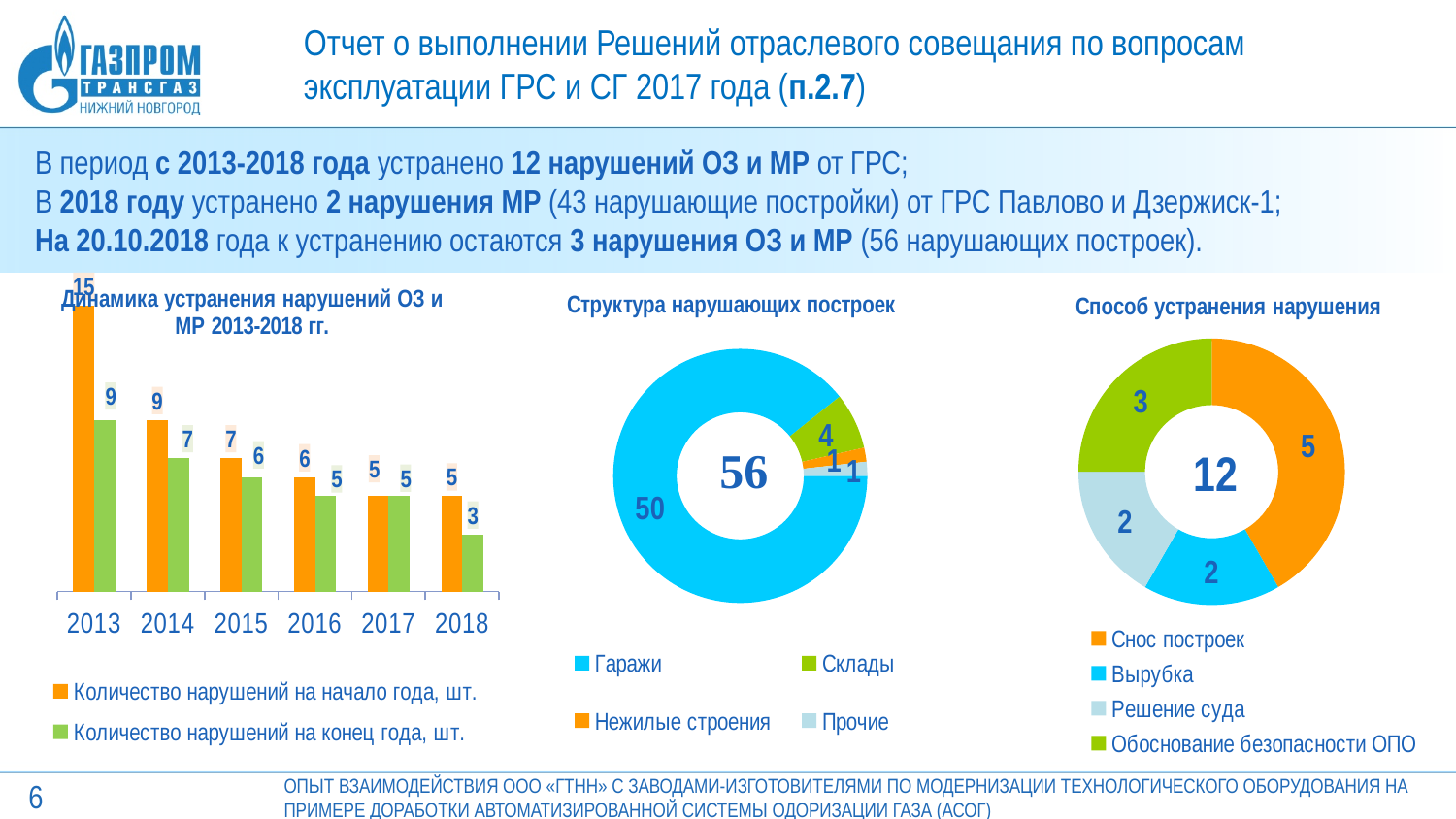
On the chart 'Динамика устранения нарушений ОЗ и МР 2013-2018 гг.', which year has the highest value of 'Количество нарушений на начало года, шт.'? 2013 On the chart 'Динамика устранения нарушений ОЗ и МР 2013-2018 гг.', does 'Количество нарушений на начало года, шт.' rise or fall from 2013 to 2018? Fall On the chart 'Способ устранения нарушения', what is the value for 'Обоснование безопасности ОПО'? 3 On the chart 'Динамика устранения нарушений ОЗ и МР 2013-2018 гг.', how many years are shown on the x axis? 6 On the chart 'Динамика устранения нарушений ОЗ и МР 2013-2018 гг.', what is the value of 'Количество нарушений на конец года, шт.' for 2018? 3 On the chart 'Способ устранения нарушения', which category has the largest value? Снос построек What kind of chart is 'Динамика устранения нарушений ОЗ и МР 2013-2018 гг.'? Bar chart On the chart 'Динамика устранения нарушений ОЗ и МР 2013-2018 гг.', what is the value of 'Количество нарушений на начало года, шт.' for 2013? 15 On the chart 'Динамика устранения нарушений ОЗ и МР 2013-2018 гг.', what is the difference between the start-of-year and end-of-year values for 2013? 6 On the chart 'Структура нарушающих построек', what is the total shown in the centre? 56 On the chart 'Структура нарушающих построек', what is the value for 'Гаражи'? 50 On the chart 'Динамика устранения нарушений ОЗ и МР 2013-2018 гг.', how many series does the legend list? 2